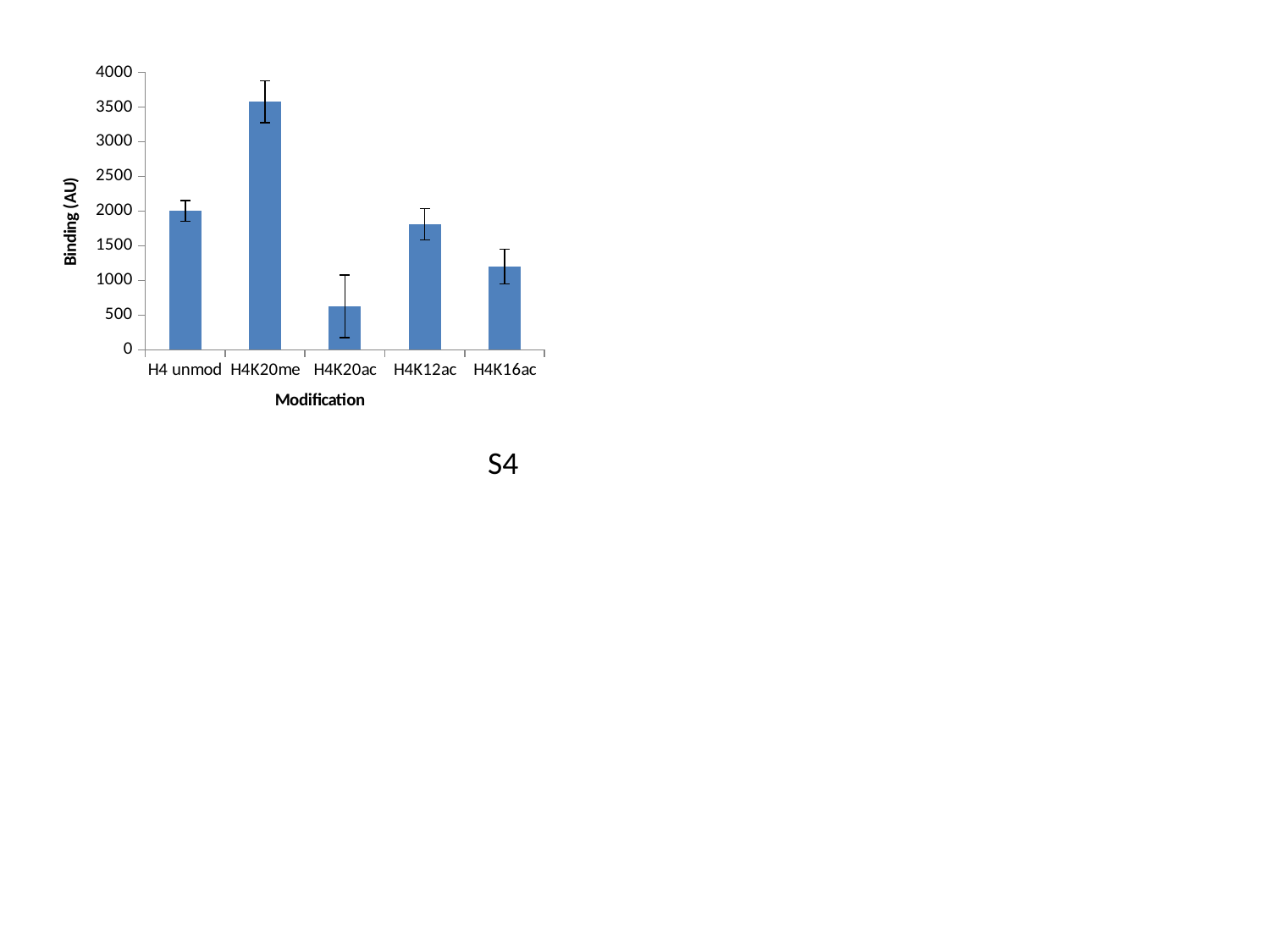
Is the binding value for H4K20ac greater or less than 1000? less Which has a larger binding value, H4K12ac or H4K16ac? H4K12ac What kind of chart is shown on the slide? bar chart What is the label of the y axis? Binding (AU) Which modification has the lowest binding value? H4K20ac What is the label of the x axis? Modification Which modification has the highest binding value? H4K20me How many modification categories are plotted on the x axis? 5 Is the binding value for H4K12ac greater or less than 1500? greater Which has a larger binding value, H4K20ac or H4K16ac? H4K16ac Which has a larger binding value, H4K20me or H4 unmod? H4K20me Is the binding value for H4K20me greater or less than 3000? greater